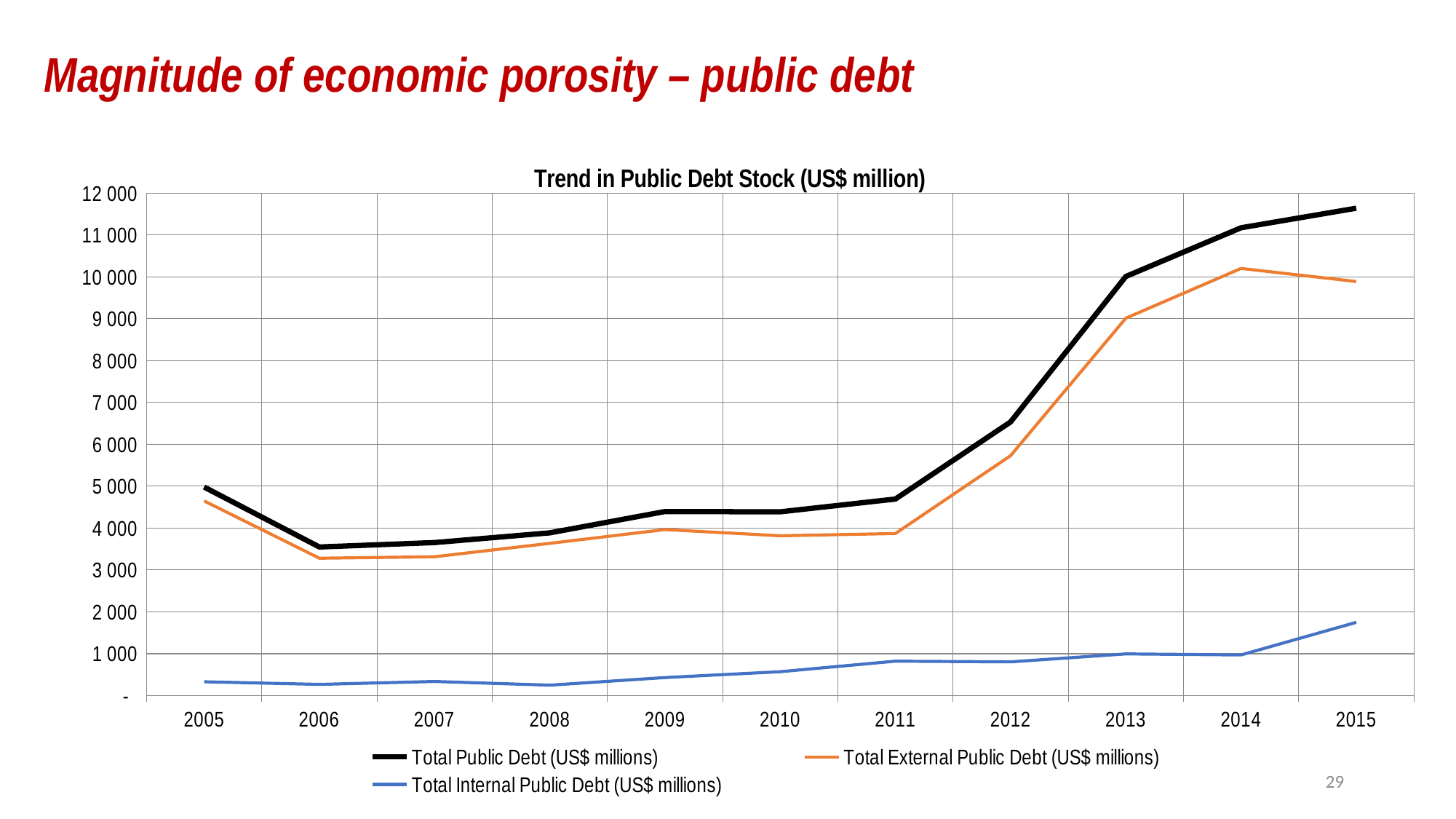
What kind of chart is shown on the slide? Line chart What is the title of the chart? Trend in Public Debt Stock (US$ million) Is the value for Total Public Debt in 2006 greater or less than 4 000? less How many years are plotted along the x axis? 11 Is the value for Total External Public Debt in 2013 greater or less than 10 000? less Is the value for Total Public Debt in 2015 greater or less than 11 000? greater Does Total Public Debt rise or fall from 2011 to 2015? Rise Which series is drawn with the black line? Total Public Debt (US$ millions) In which year is Total Public Debt highest? 2015 Which is larger in 2013: Total External Public Debt or Total Internal Public Debt? Total External Public Debt How many series does the legend list? 3